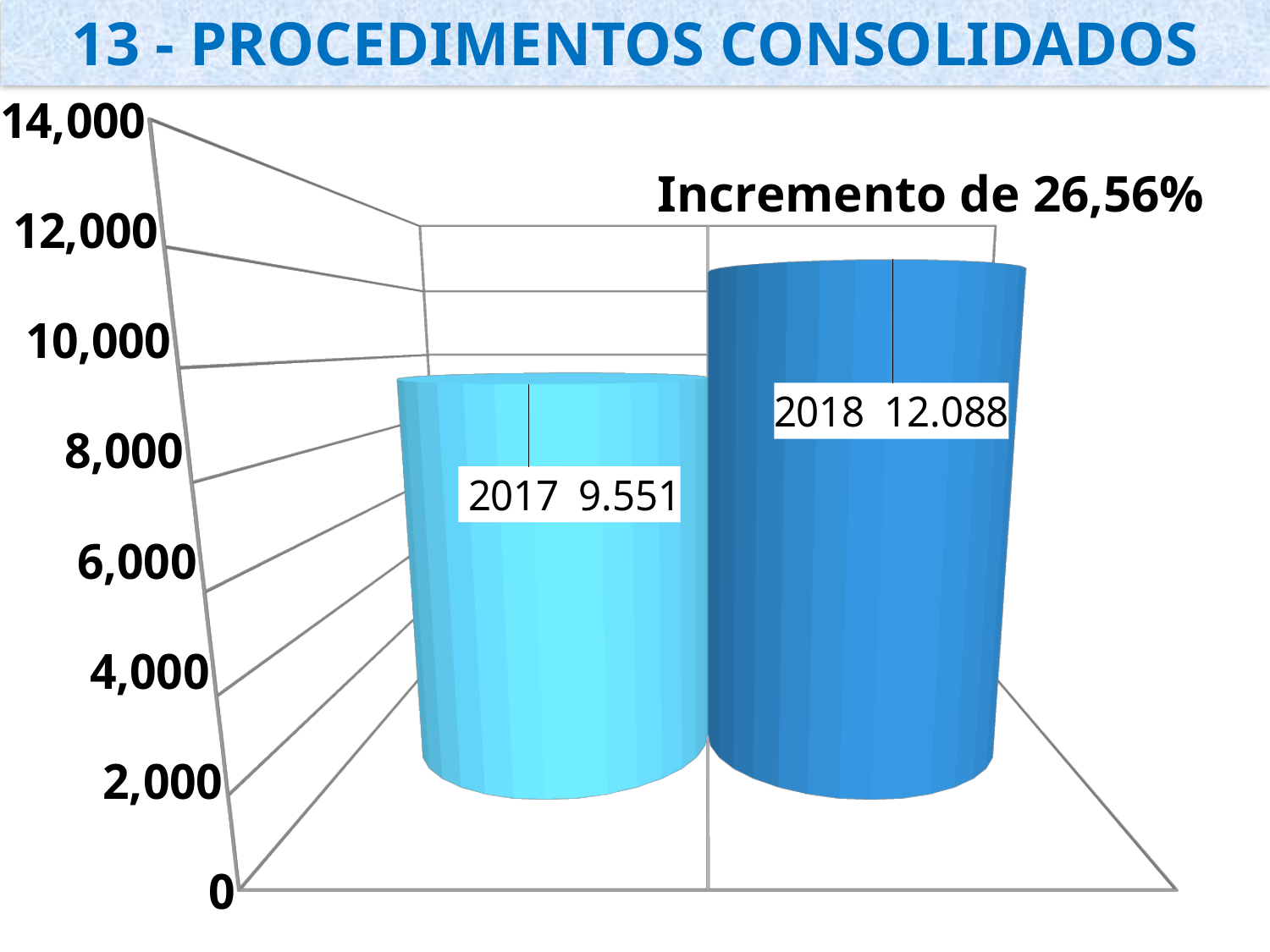
Is the value for 2018 greater or less than 12,000? greater What percentage increase is stated on the chart? 26,56% Is the value for 2018 larger than the value for 2017? Yes What is the value for 2018? 12.088 What kind of chart is shown on the slide? Bar chart How many bars are plotted in the chart? 2 Which year has the lower value? 2017 What is the difference between the 2018 value and the 2017 value? 2.537 What is the value for 2017? 9.551 Do the values rise or fall from 2017 to 2018? Rise Is the value for 2017 greater or less than 10,000? less Which year has the higher value? 2018